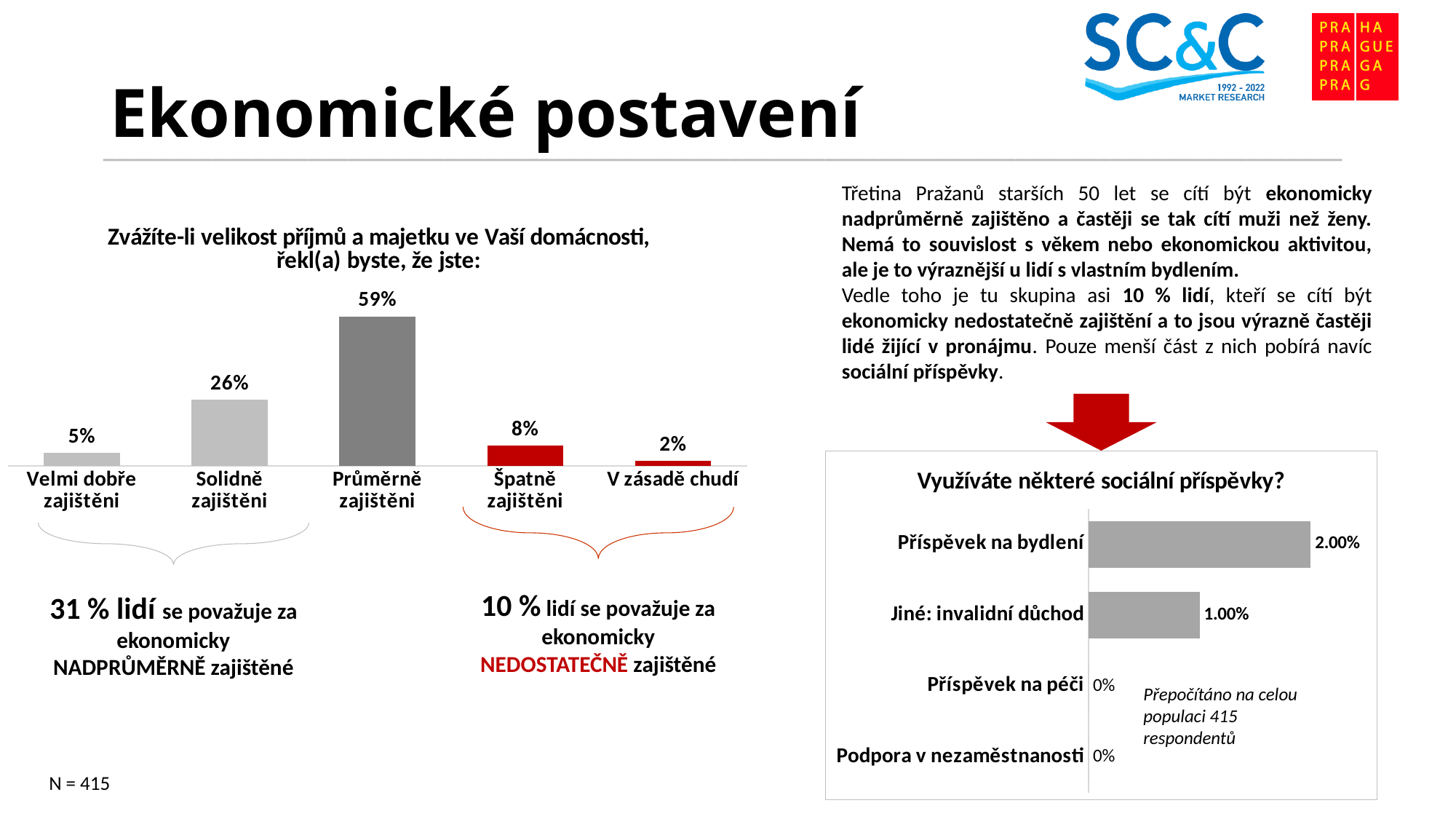
In the left chart 'Zvážíte-li velikost příjmů a majetku ve Vaší domácnosti, řekl(a) byste, že jste:', what is the value for 'Špatně zajištěni'? 8% How many categories does the right chart 'Využíváte některé sociální příspěvky?' show? 4 In the right chart 'Využíváte některé sociální příspěvky?', what is the value for 'Jiné: invalidní důchod'? 1.00% In the left chart 'Zvážíte-li velikost příjmů a majetku ve Vaší domácnosti, řekl(a) byste, že jste:', which category has the lowest value? V zásadě chudí In the right chart 'Využíváte některé sociální příspěvky?', what is the value for 'Příspěvek na bydlení'? 2.00% What kind of chart is the left chart 'Zvážíte-li velikost příjmů a majetku ve Vaší domácnosti, řekl(a) byste, že jste:'? Bar chart In the left chart 'Zvážíte-li velikost příjmů a majetku ve Vaší domácnosti, řekl(a) byste, že jste:', which category has the highest value? Průměrně zajištěni In the right chart 'Využíváte některé sociální příspěvky?', which category has the highest value? Příspěvek na bydlení In the left chart 'Zvážíte-li velikost příjmů a majetku ve Vaší domácnosti, řekl(a) byste, že jste:', what is the difference between 'Solidně zajištěni' and 'Velmi dobře zajištěni'? 21% In the left chart 'Zvážíte-li velikost příjmů a majetku ve Vaší domácnosti, řekl(a) byste, že jste:', which is larger: 'Špatně zajištěni' or 'Velmi dobře zajištěni'? Špatně zajištěni In the left chart 'Zvážíte-li velikost příjmů a majetku ve Vaší domácnosti, řekl(a) byste, že jste:', what is the value for 'Průměrně zajištěni'? 59% How many categories does the left chart 'Zvážíte-li velikost příjmů a majetku ve Vaší domácnosti, řekl(a) byste, že jste:' show? 5